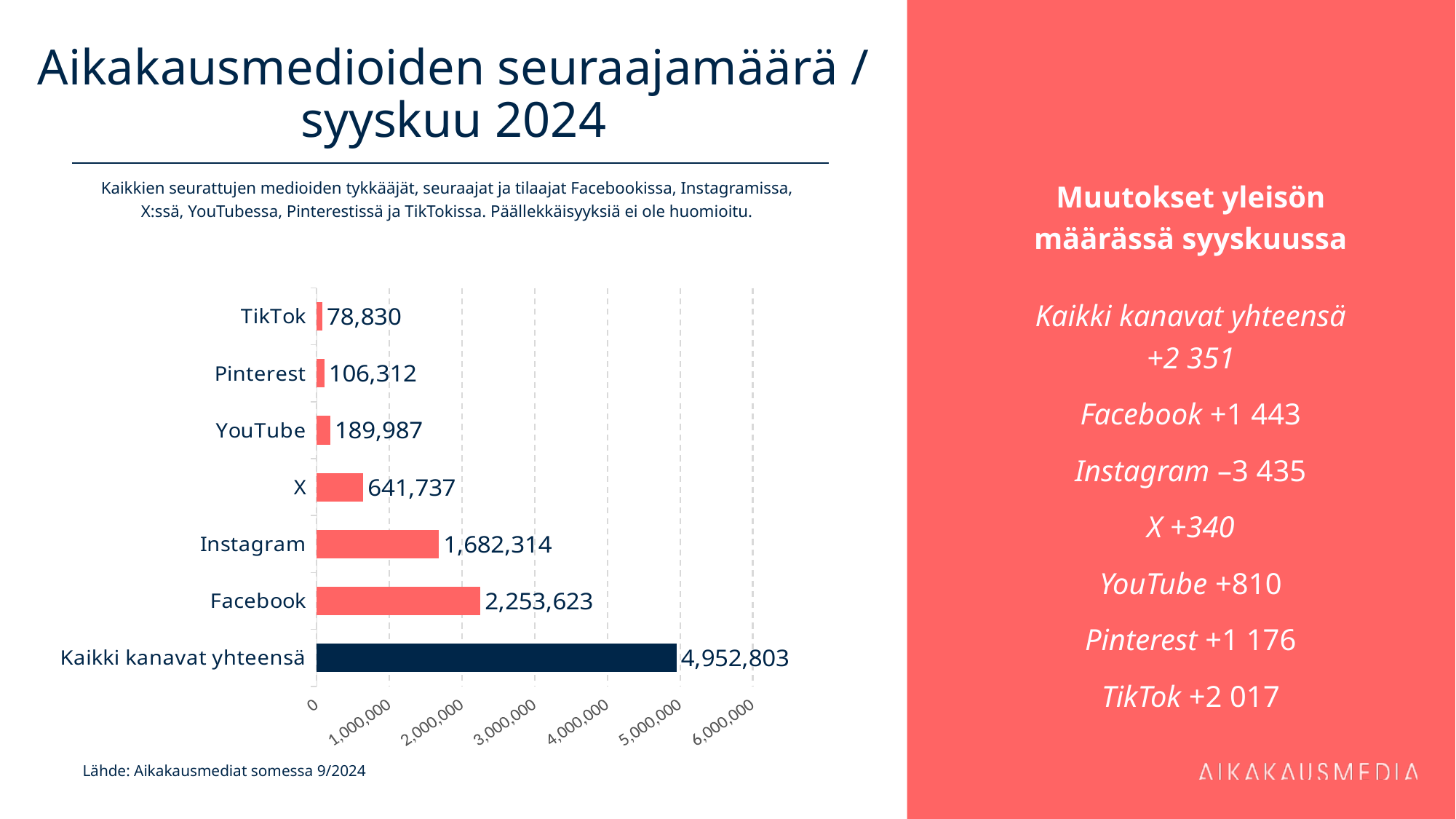
What is the value for Instagram? 1,682,314 What is the value for Facebook? 2,253,623 What is the difference between the values for Facebook and Instagram? 571,309 How many categories are shown in the chart? 7 Which category has the highest value? Kaikki kanavat yhteensä Is the value for X greater or less than 1,000,000? less Which is larger, the value for Pinterest or the value for YouTube? YouTube What is the value for Kaikki kanavat yhteensä? 4,952,803 What is the difference between the values for X and YouTube? 451,750 What is the value for TikTok? 78,830 Which category has the lowest value? TikTok What kind of chart is shown on the slide? bar chart